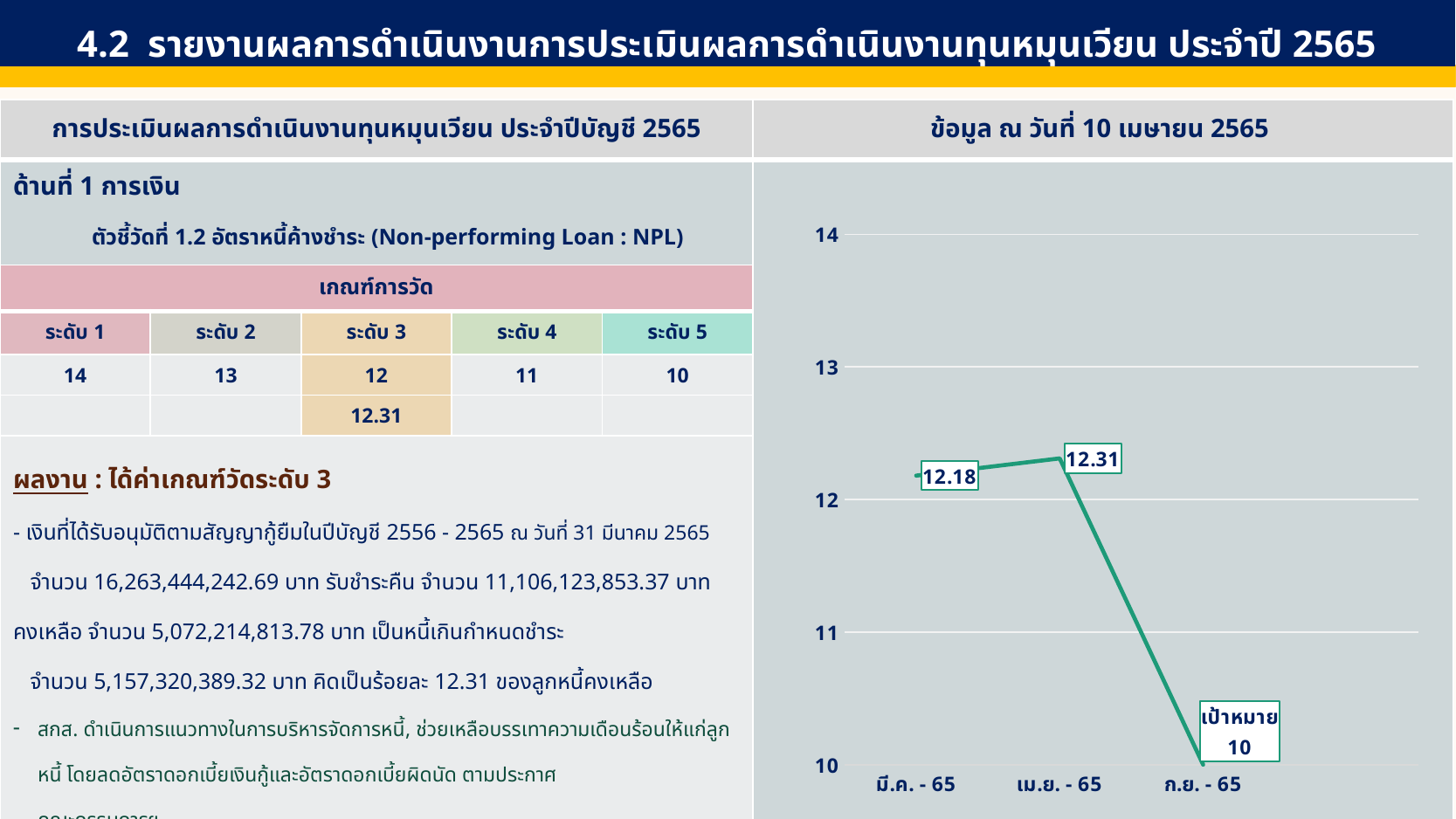
What is the difference between the values for เม.ย. - 65 and มี.ค. - 65? 0.13 Is the value for มี.ค. - 65 greater or less than 12? greater What kind of chart is shown on the right side of the slide? line chart Which is larger, the value for มี.ค. - 65 or the value for เม.ย. - 65? เม.ย. - 65 How many data points are plotted on the line chart? 3 Does the line rise or fall between เม.ย. - 65 and ก.ย. - 65? fall What is the target (เป้าหมาย) value plotted for ก.ย. - 65? 10 What is the difference between the value for เม.ย. - 65 and the target for ก.ย. - 65? 2.31 Which category has the lowest plotted value? ก.ย. - 65 What is the value plotted for มี.ค. - 65? 12.18 What is the value plotted for เม.ย. - 65? 12.31 Which category has the highest plotted value? เม.ย. - 65